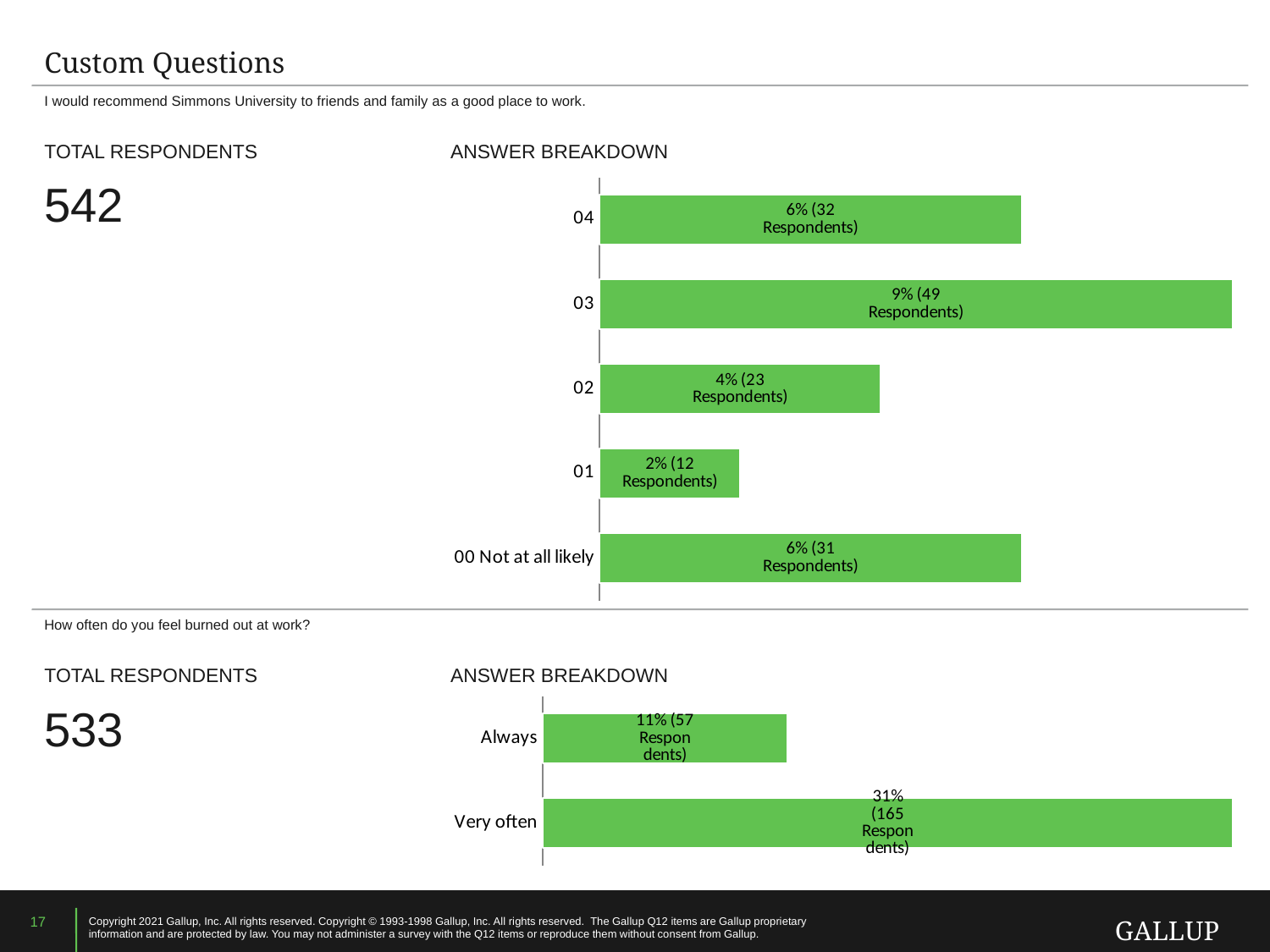
In the chart for 'I would recommend Simmons University to friends and family as a good place to work', what percentage is shown for '00 Not at all likely'? 6% How many category bars are shown in the chart for 'I would recommend Simmons University to friends and family as a good place to work'? 5 In the chart for 'I would recommend Simmons University to friends and family as a good place to work', how many more respondents chose 03 than 02? 26 In the chart for 'How often do you feel burned out at work?', how many more respondents answered 'Very often' than 'Always'? 108 What type of chart is used for the 'How often do you feel burned out at work?' answer breakdown? Bar chart In the chart for 'I would recommend Simmons University to friends and family as a good place to work', which of the bars shown has the highest value? 03 In the chart for 'I would recommend Simmons University to friends and family as a good place to work', which of the bars shown has the lowest value? 01 In the chart for 'How often do you feel burned out at work?', what is the value shown for 'Very often'? 31% (165 Respondents) In the chart for 'I would recommend Simmons University to friends and family as a good place to work', what is the value shown for category 03? 9% (49 Respondents) In the chart for 'I would recommend Simmons University to friends and family as a good place to work', how many respondents chose 01? 12 In the chart for 'I would recommend Simmons University to friends and family as a good place to work', which has more respondents, 04 or 02? 04 In the chart for 'How often do you feel burned out at work?', what percentage of respondents answered 'Always'? 11%